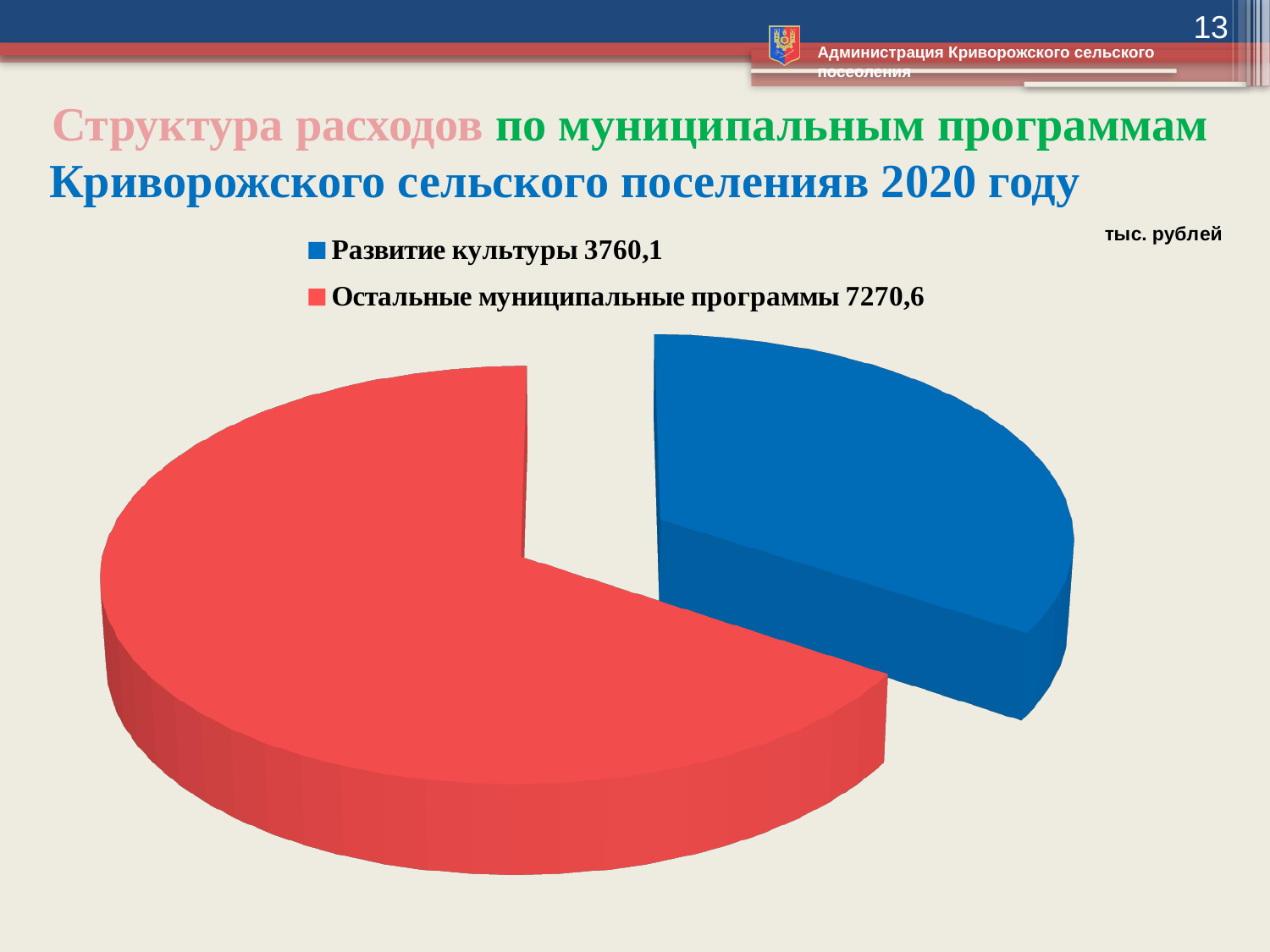
What is the difference between Остальные муниципальные программы and Развитие культуры? 3510,5 What kind of chart is shown on the slide? pie chart How many slices does the pie chart have? 2 Which category has the largest value? Остальные муниципальные программы What colour is the slice for Развитие культуры? blue Which is larger: Развитие культуры or Остальные муниципальные программы? Остальные муниципальные программы How many entries does the legend list? 2 What is the total of the two values shown in the pie chart? 11030,7 What is the value for Остальные муниципальные программы? 7270,6 What is the value for Развитие культуры? 3760,1 What unit is stated for the values in the chart? тыс. рублей Which category has the smallest value? Развитие культуры